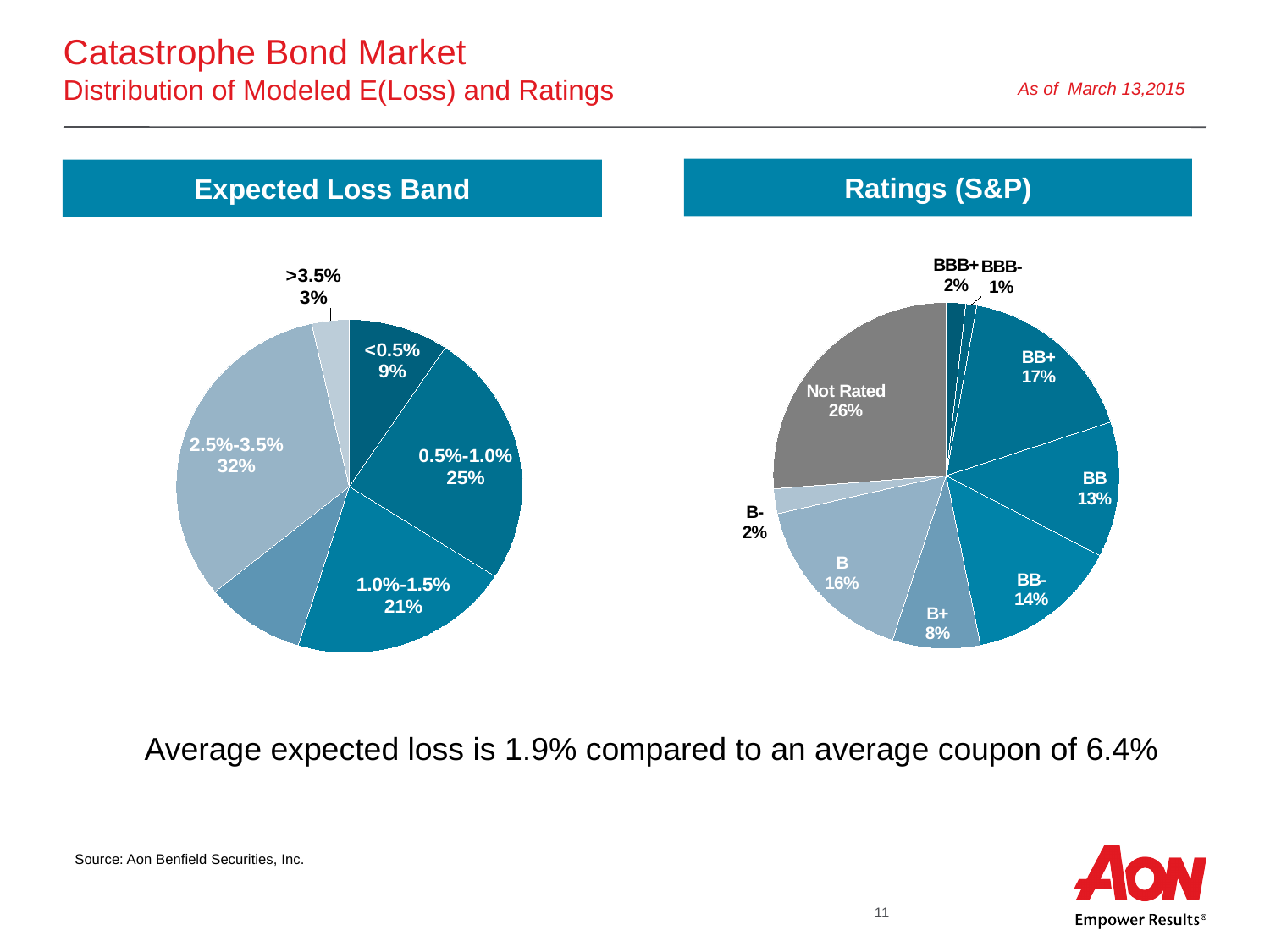
What type of chart is used for the Ratings (S&P) data? Pie chart In the Expected Loss Band chart, which labeled band has the smallest share? >3.5% In the Ratings (S&P) chart, how many slices does the pie have? 9 In the Ratings (S&P) chart, what share is Not Rated? 26% In the Ratings (S&P) chart, which is larger, the share rated B or the share rated BB-? B In the Ratings (S&P) chart, what share is rated BB+? 17% In the Expected Loss Band chart, what share does the 2.5%-3.5% band have? 32% In the Expected Loss Band chart, what share does the 0.5%-1.0% band have? 25% In the Expected Loss Band chart, which labeled band has the largest share? 2.5%-3.5% In the Ratings (S&P) chart, which rating category has the smallest share? BBB- In the Expected Loss Band chart, what is the difference between the 0.5%-1.0% share and the 1.0%-1.5% share? 4% In the Ratings (S&P) chart, what is the difference between the BB+ share and the B+ share? 9%